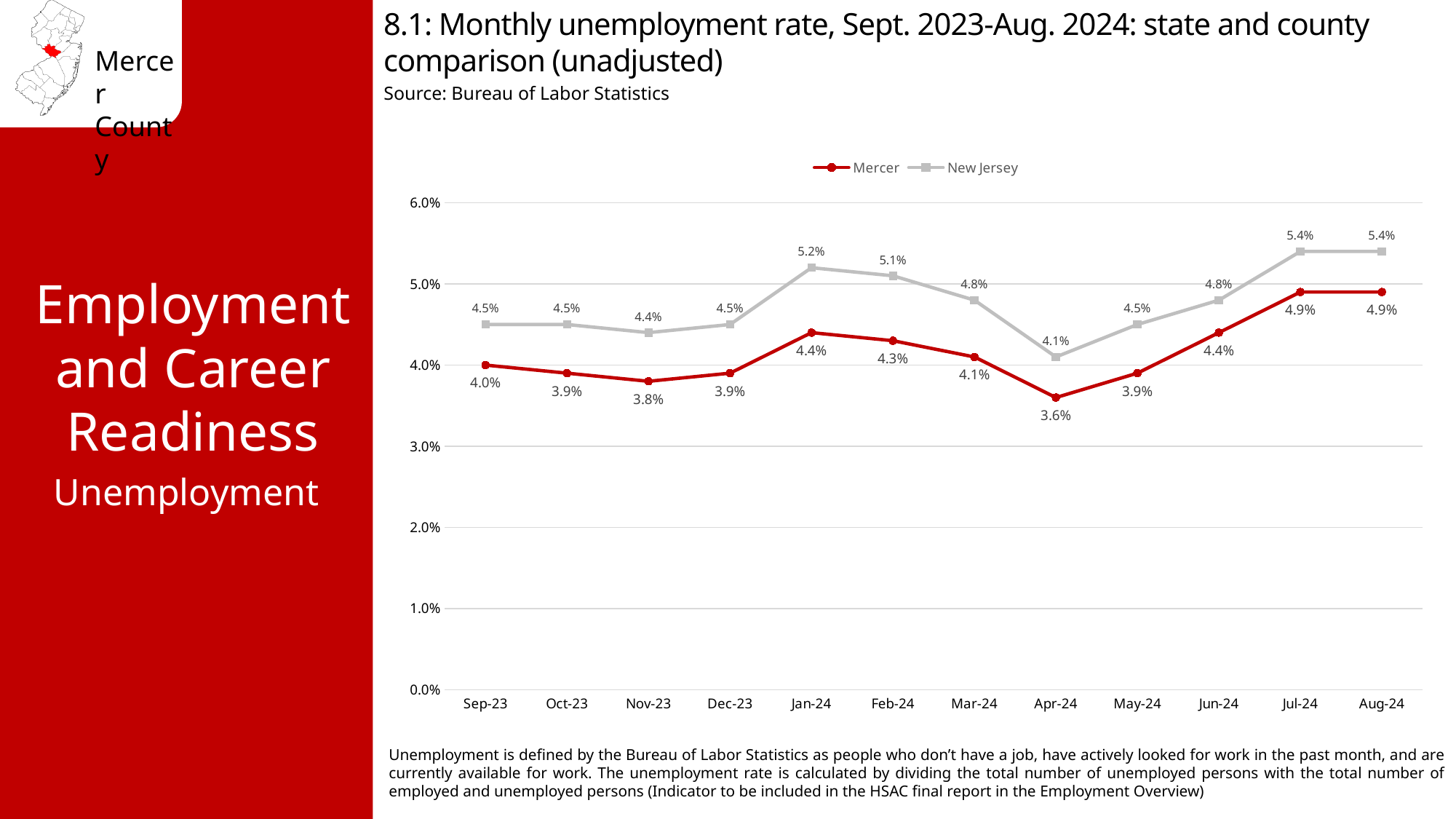
Which had the higher unemployment rate in Mar-24, Mercer or New Jersey? New Jersey What kind of chart is shown on the slide? Line chart What is the difference between the New Jersey and Mercer unemployment rates in Aug-24? 0.5% In which month was the Mercer unemployment rate lowest? Apr-24 In which month was the New Jersey unemployment rate lowest? Apr-24 Did the Mercer unemployment rate rise or fall from Apr-24 to Jul-24? Rise What is the source cited for the chart? Bureau of Labor Statistics Is the Mercer unemployment rate in Jul-24 greater or less than 5.0%? less What was the New Jersey unemployment rate in Jan-24? 5.2% How many months are shown on the x axis? 12 What was the Mercer unemployment rate in Apr-24? 3.6% How many series does the legend list? 2